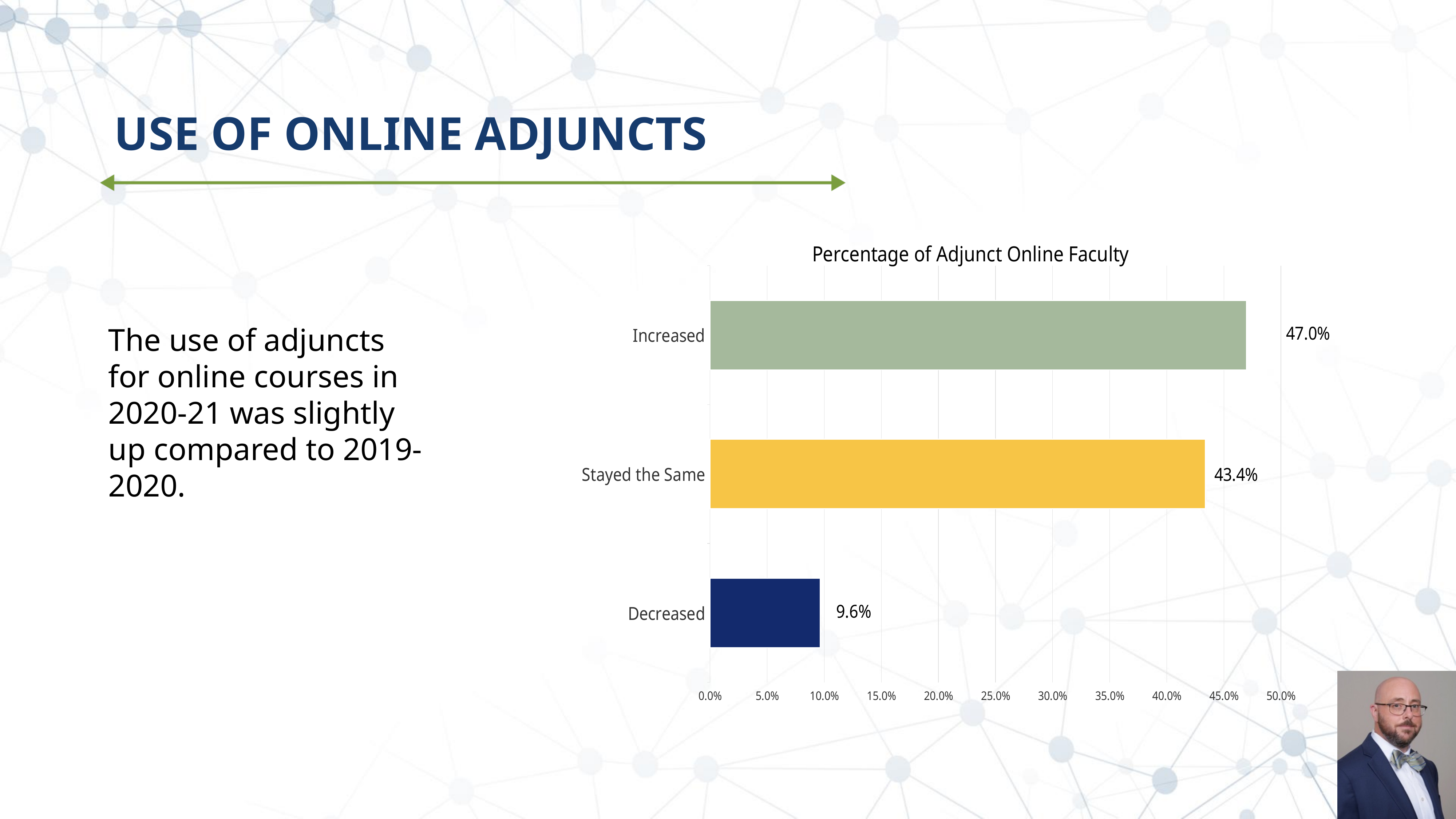
What is the difference between the values for Increased and Stayed the Same? 3.6% Which category has the highest value? Increased Which is larger, the value for Increased or the value for Decreased? Increased What is the difference between the values for Stayed the Same and Decreased? 33.8% Is the value for Stayed the Same greater or less than 40.0%? greater What is the value for Stayed the Same? 43.4% What is the value for Increased? 47.0% How many categories are shown in the chart? 3 Which category has the lowest value? Decreased What kind of chart is shown on the slide? Bar chart What is the value for Decreased? 9.6% What is the title of the chart? Percentage of Adjunct Online Faculty